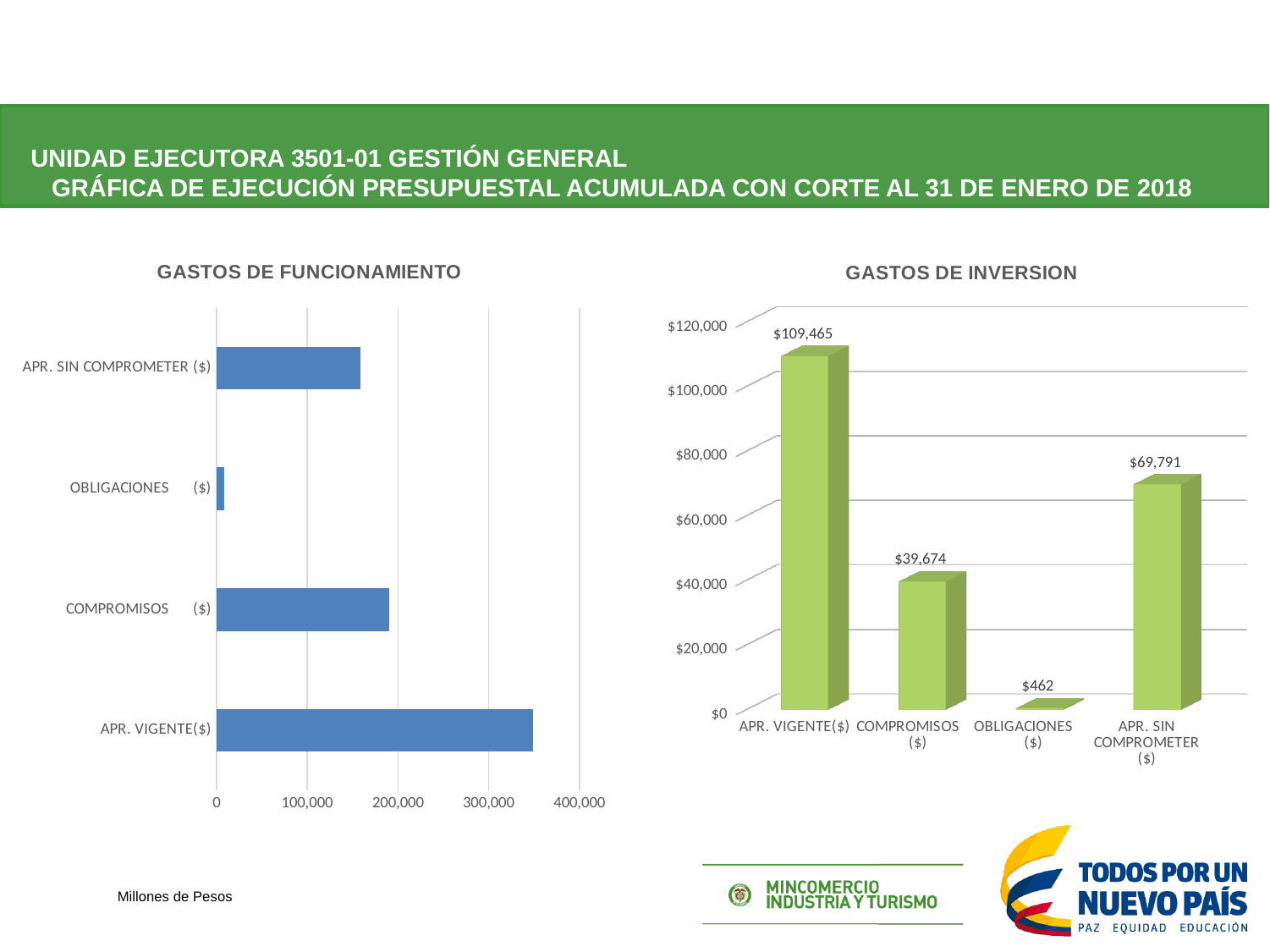
In the GASTOS DE INVERSION chart, what is the value for OBLIGACIONES ($)? $462 In the GASTOS DE INVERSION chart, what is the value for APR. SIN COMPROMETER ($)? $69,791 In the GASTOS DE FUNCIONAMIENTO chart, is the value for COMPROMISOS ($) greater or less than 200,000? less In the GASTOS DE INVERSION chart, what is the difference between COMPROMISOS ($) and OBLIGACIONES ($)? $39,212 In the GASTOS DE FUNCIONAMIENTO chart, is the value for APR. VIGENTE($) greater or less than 300,000? greater In the GASTOS DE INVERSION chart, what is the value for APR. VIGENTE($)? $109,465 What type of chart is the GASTOS DE FUNCIONAMIENTO chart? Bar chart In the GASTOS DE INVERSION chart, what is the value for COMPROMISOS ($)? $39,674 In the GASTOS DE INVERSION chart, what is the difference between APR. VIGENTE($) and APR. SIN COMPROMETER ($)? $39,674 In the GASTOS DE FUNCIONAMIENTO chart, which is larger, COMPROMISOS ($) or OBLIGACIONES ($)? COMPROMISOS ($) In the GASTOS DE FUNCIONAMIENTO chart, which category has the highest value? APR. VIGENTE($) In the GASTOS DE INVERSION chart, which category has the lowest value? OBLIGACIONES ($)